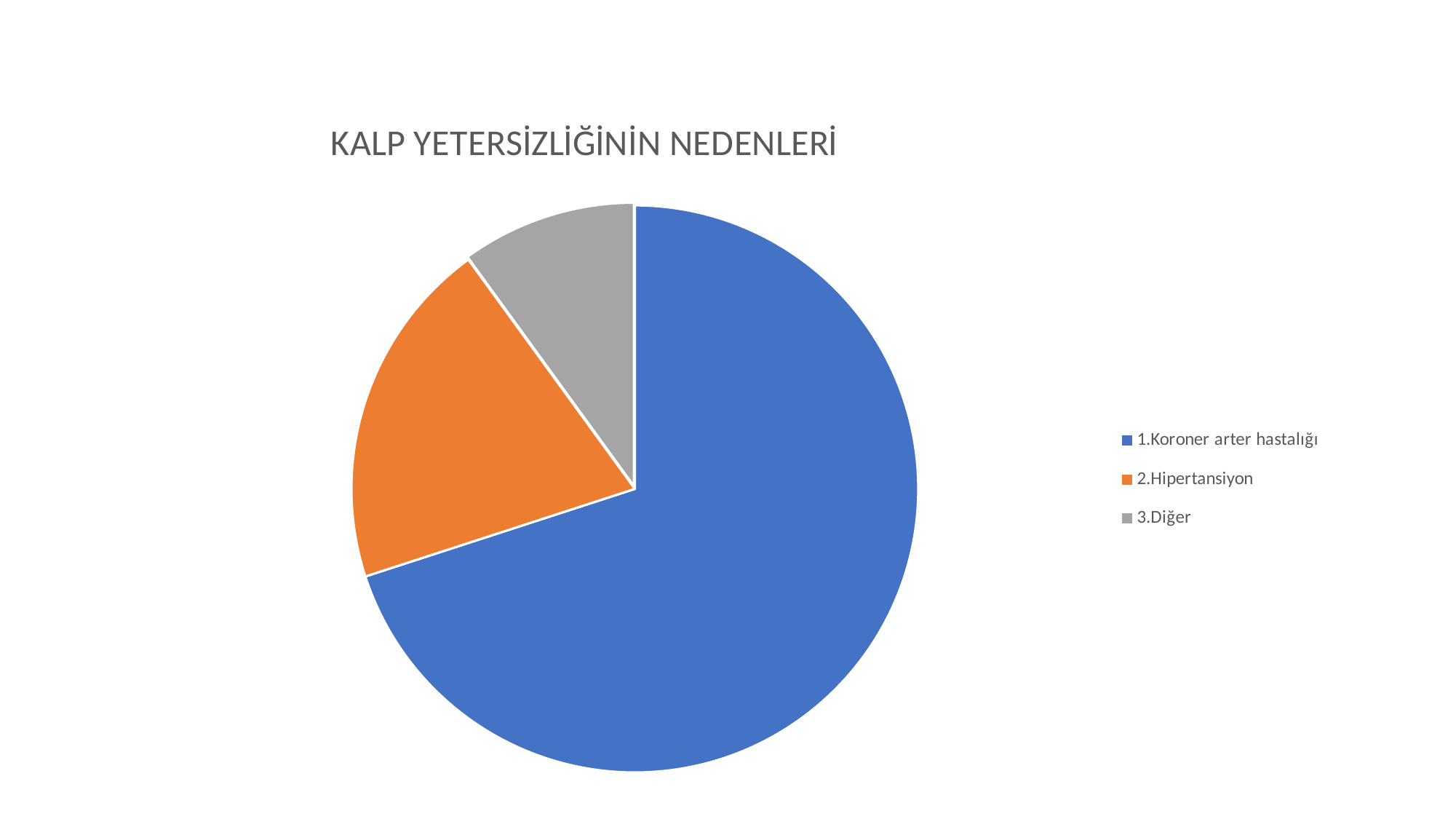
Which slice is larger, 1.Koroner arter hastalığı or 2.Hipertansiyon? 1.Koroner arter hastalığı What is the title of the chart? KALP YETERSİZLİĞİNİN NEDENLERİ What colour is the slice for 2.Hipertansiyon? orange Which slice is larger, 2.Hipertansiyon or 3.Diğer? 2.Hipertansiyon Which category has the smallest slice of the pie? 3.Diğer How many entries does the legend list? 3 How many slices does the pie chart have? 3 What kind of chart is shown on the slide? pie chart Which category has the largest slice of the pie? 1.Koroner arter hastalığı